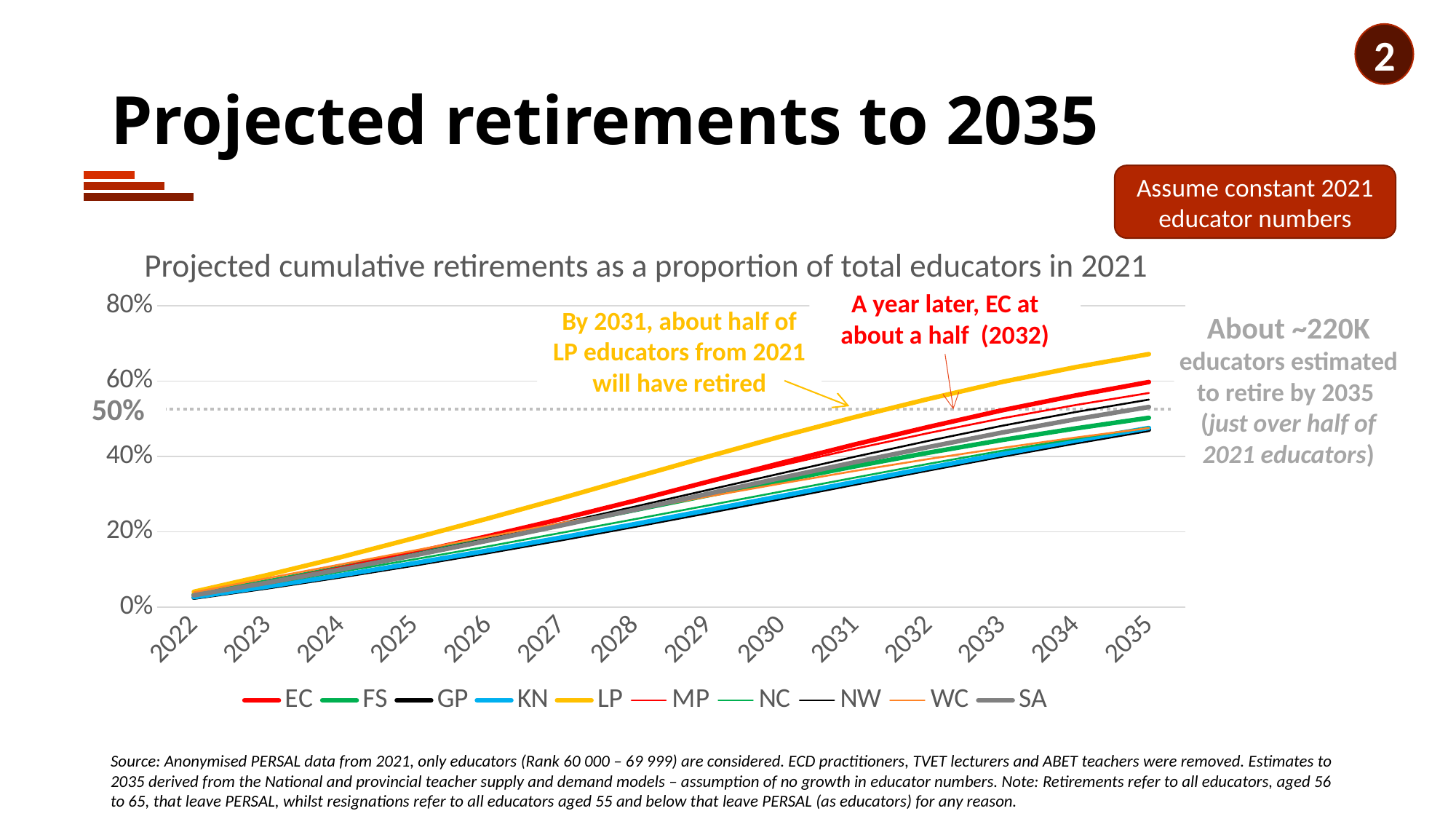
Is the value for LP in 2035 greater or less than 60%? greater Which series has the highest value in 2035? LP Is the value for EC in 2026 greater or less than 40%? less What kind of chart is shown on the slide? Line chart Is the value for KN in 2035 greater or less than 60%? less Which is larger in 2035, the value for LP or the value for KN? LP Do the values for the series rise or fall from 2022 to 2035? Rise How many years are shown along the x axis? 14 What is the title of the chart? Projected cumulative retirements as a proportion of total educators in 2021 What is the first year shown on the x axis? 2022 How many series does the legend list? 10